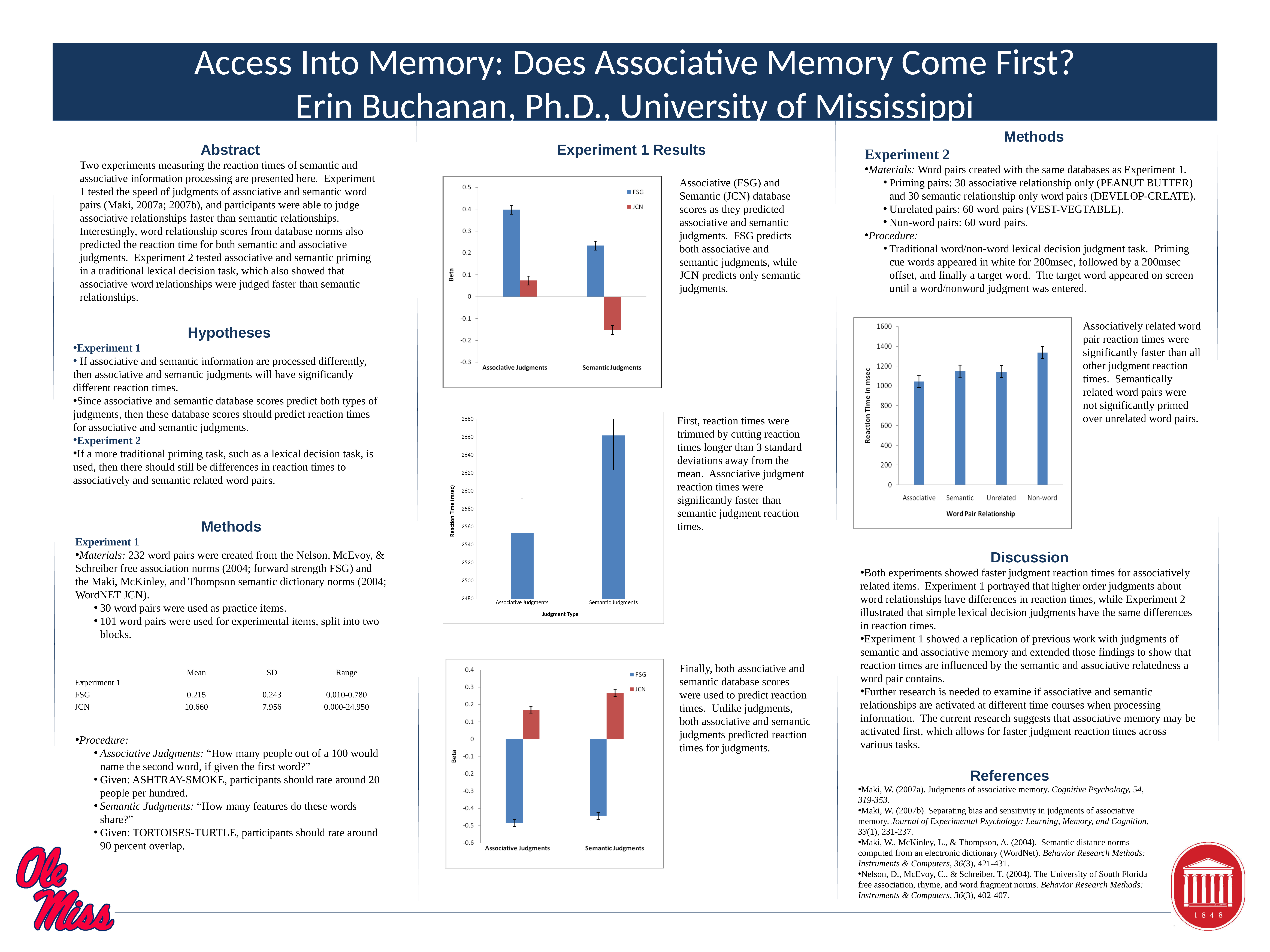
In the bottom chart of the middle column (Beta by judgment type), is the FSG value for Associative Judgments greater or less than -0.4? less In the top chart of the middle column (Beta by judgment type), is the JCN value for Semantic Judgments greater or less than 0? less In the bottom chart of the middle column (Beta by judgment type), which is larger for Semantic Judgments, FSG or JCN? JCN In the top chart of the middle column (Beta by judgment type), is the FSG value for Associative Judgments greater or less than 0.3? greater In the middle chart of the middle column (Reaction Time by Judgment Type), which judgment type has the higher reaction time? Semantic Judgments In the chart in the right column (Reaction Time in msec by Word Pair Relationship), how many word pair relationship categories are shown? 4 In the top chart of the middle column (Beta by judgment type), which is larger for Associative Judgments, FSG or JCN? FSG In the top chart of the middle column (Beta by judgment type), how many series does the legend list? 2 What kind of chart is the middle chart of the middle column (Reaction Time by Judgment Type)? bar chart In the chart in the right column (Reaction Time in msec by Word Pair Relationship), which category has the highest reaction time? Non-word